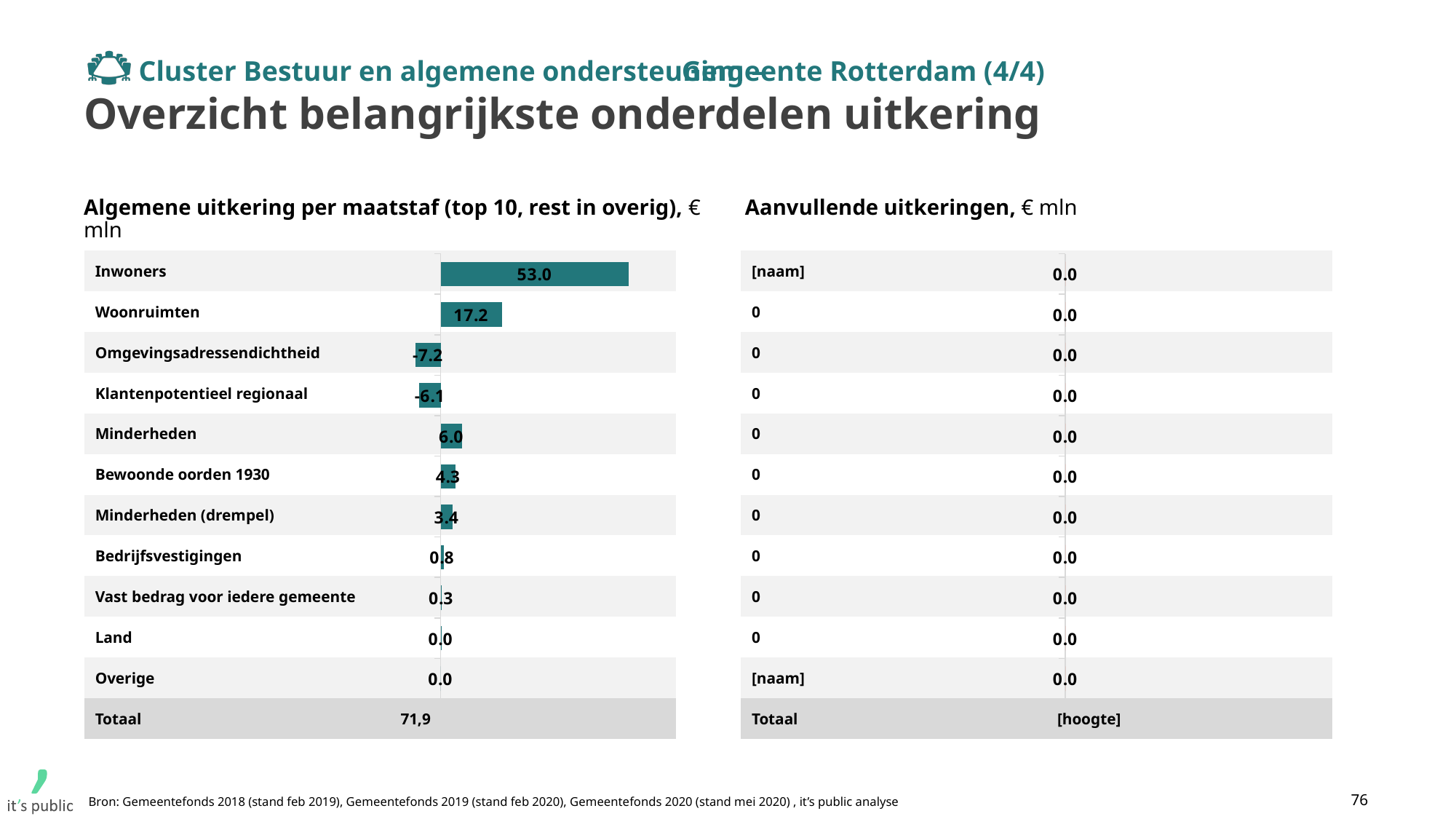
In the chart 'Algemene uitkering per maatstaf', what is the value for Klantenpotentieel regionaal? -6.1 In the chart 'Algemene uitkering per maatstaf', which category has the highest value? Inwoners In the chart 'Algemene uitkering per maatstaf', what is the value for Bewoonde oorden 1930? 4.3 In the chart 'Algemene uitkering per maatstaf', which category has the lowest value? Omgevingsadressendichtheid In the chart 'Algemene uitkering per maatstaf', what is the value for Woonruimten? 17.2 In the chart 'Algemene uitkering per maatstaf', what is the value for Inwoners? 53.0 In the chart 'Algemene uitkering per maatstaf', which is larger: the value for Minderheden or the value for Minderheden (drempel)? Minderheden How many categories are shown in the chart 'Algemene uitkering per maatstaf' (excluding the Totaal row)? 11 What is the Totaal shown below the chart 'Algemene uitkering per maatstaf'? 71,9 What type of chart is 'Algemene uitkering per maatstaf'? Bar chart In the chart 'Algemene uitkering per maatstaf', what is the value for Omgevingsadressendichtheid? -7.2 In the chart 'Algemene uitkering per maatstaf', what is the difference between the values for Inwoners and Woonruimten? 35.8